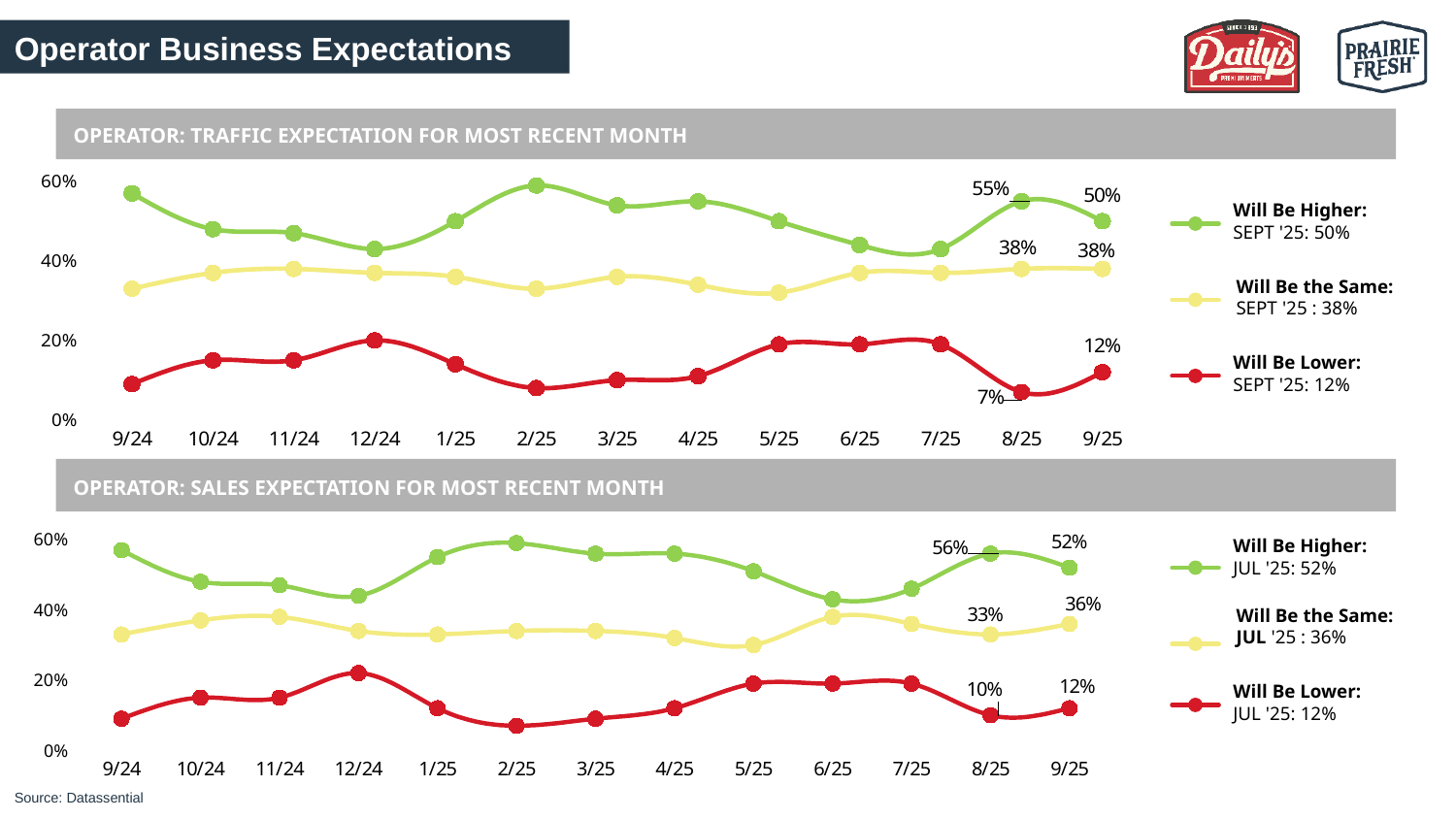
In the Operator: Traffic Expectation chart, what is the value for 'Will Be Higher' at 9/25? 50% In the Operator: Sales Expectation chart, what is the difference between 'Will Be Higher' at 8/25 and at 9/25? 4% In the Operator: Traffic Expectation chart, which series has the highest value at 9/25? Will Be Higher In the Operator: Traffic Expectation chart, is the value for 'Will Be Higher' at 2/25 greater or less than 40%? greater In the Operator: Sales Expectation chart, which series has the lowest value at 8/25? Will Be Lower In the Operator: Traffic Expectation chart, what is the difference between 'Will Be Higher' and 'Will Be the Same' at 9/25? 12% In the Operator: Sales Expectation chart, what is the value for 'Will Be the Same' at 9/25? 36% In the Operator: Sales Expectation chart, is the value for 'Will Be Lower' at 12/24 greater or less than 40%? less How many months are plotted along the x axis of the Operator: Traffic Expectation chart? 13 In the Operator: Sales Expectation chart, what is the value for 'Will Be Higher' at 8/25? 56% In the Operator: Traffic Expectation chart, what is the value for 'Will Be Lower' at 8/25? 7% How many series does the legend of the Operator: Sales Expectation chart list? 3